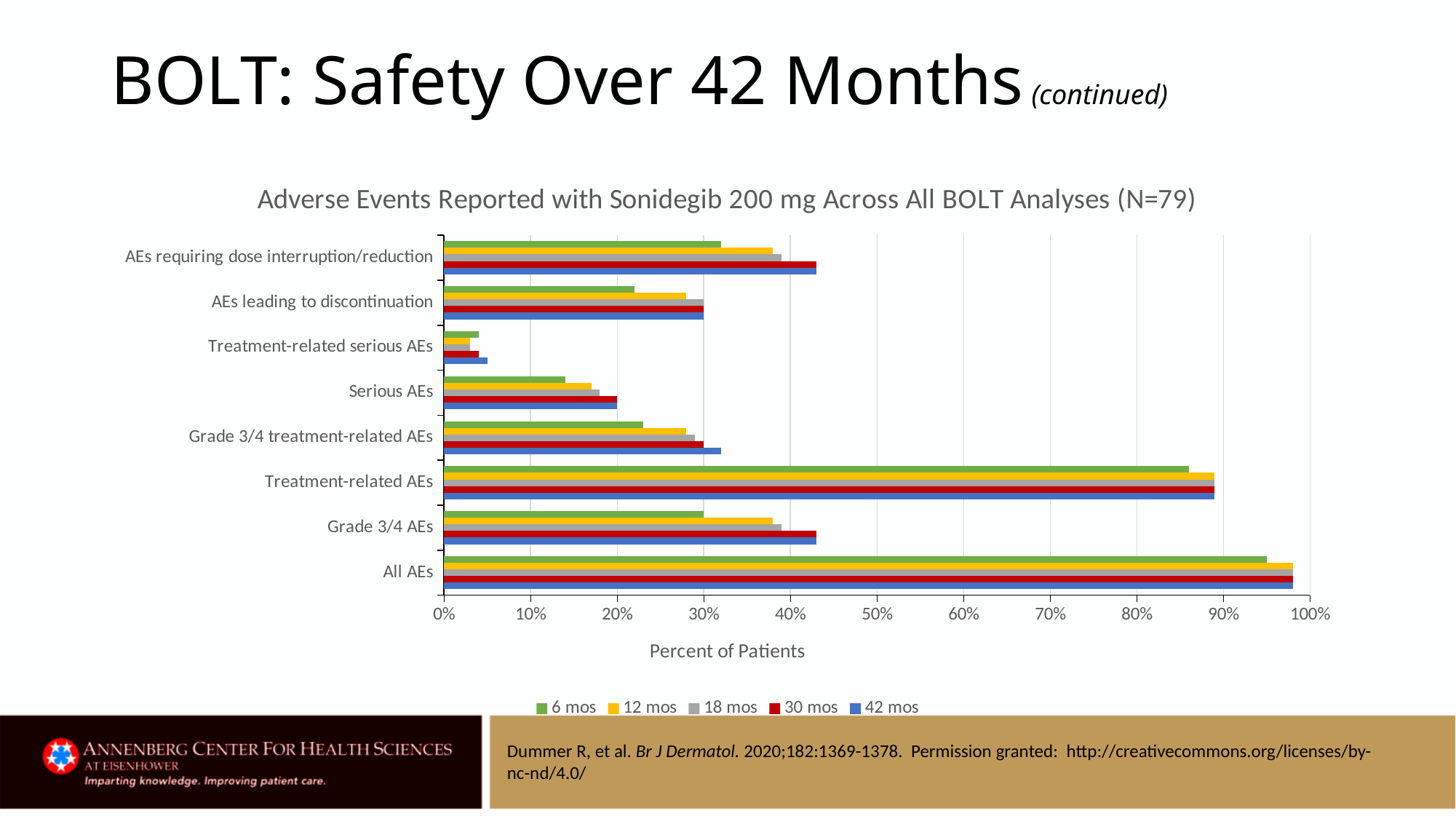
Is the 6 mos value for Serious AEs greater or less than 10%? greater At 42 mos, which is larger: Grade 3/4 AEs or Serious AEs? Grade 3/4 AEs How many series does the legend list? 5 What kind of chart is shown on the slide? bar chart Is the 6 mos value for Treatment-related AEs greater or less than 80%? greater Which adverse event category has the highest values across all time points? All AEs Which adverse event category has the lowest values across all time points? Treatment-related serious AEs Is the 42 mos value for Treatment-related serious AEs greater or less than 10%? less What is the label of the horizontal axis? Percent of Patients How many adverse event categories are plotted on the chart? 8